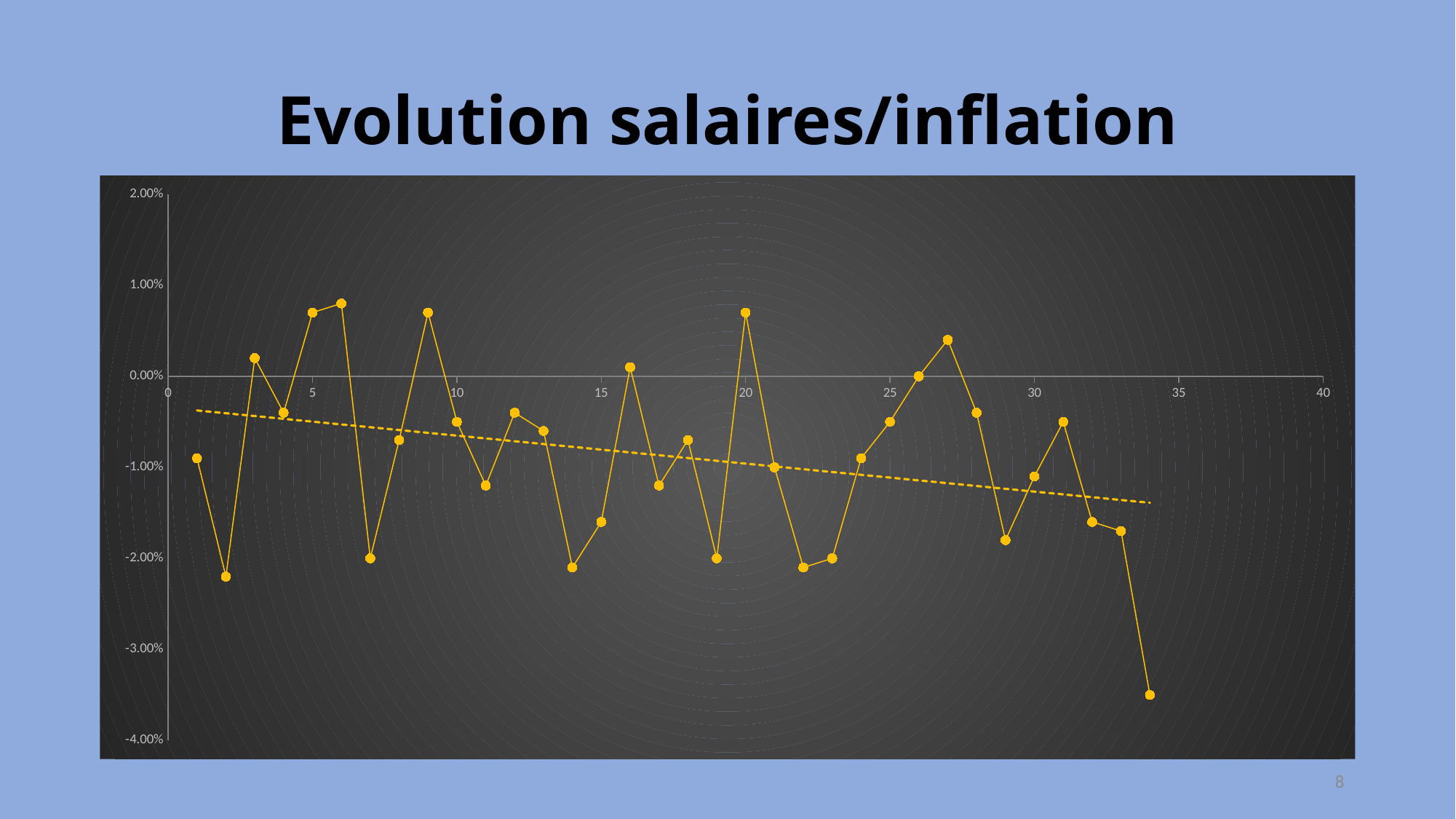
What is the title of the chart? Evolution salaires/inflation Is the value at x = 34 greater or less than -3.00%? less What is the highest value shown on the vertical axis? 2.00% Is the value at x = 2 greater or less than -2.00%? less Is the value at x = 6 greater or less than 0.00%? greater At which x value does the series reach its lowest point? 34 Which has the larger value, the point at x = 1 or the point at x = 2? x = 1 Which has the larger value, the point at x = 19 or the point at x = 20? x = 20 What kind of chart is shown on the slide? Line chart Does the dashed trend line rise or fall as the x axis increases? Fall